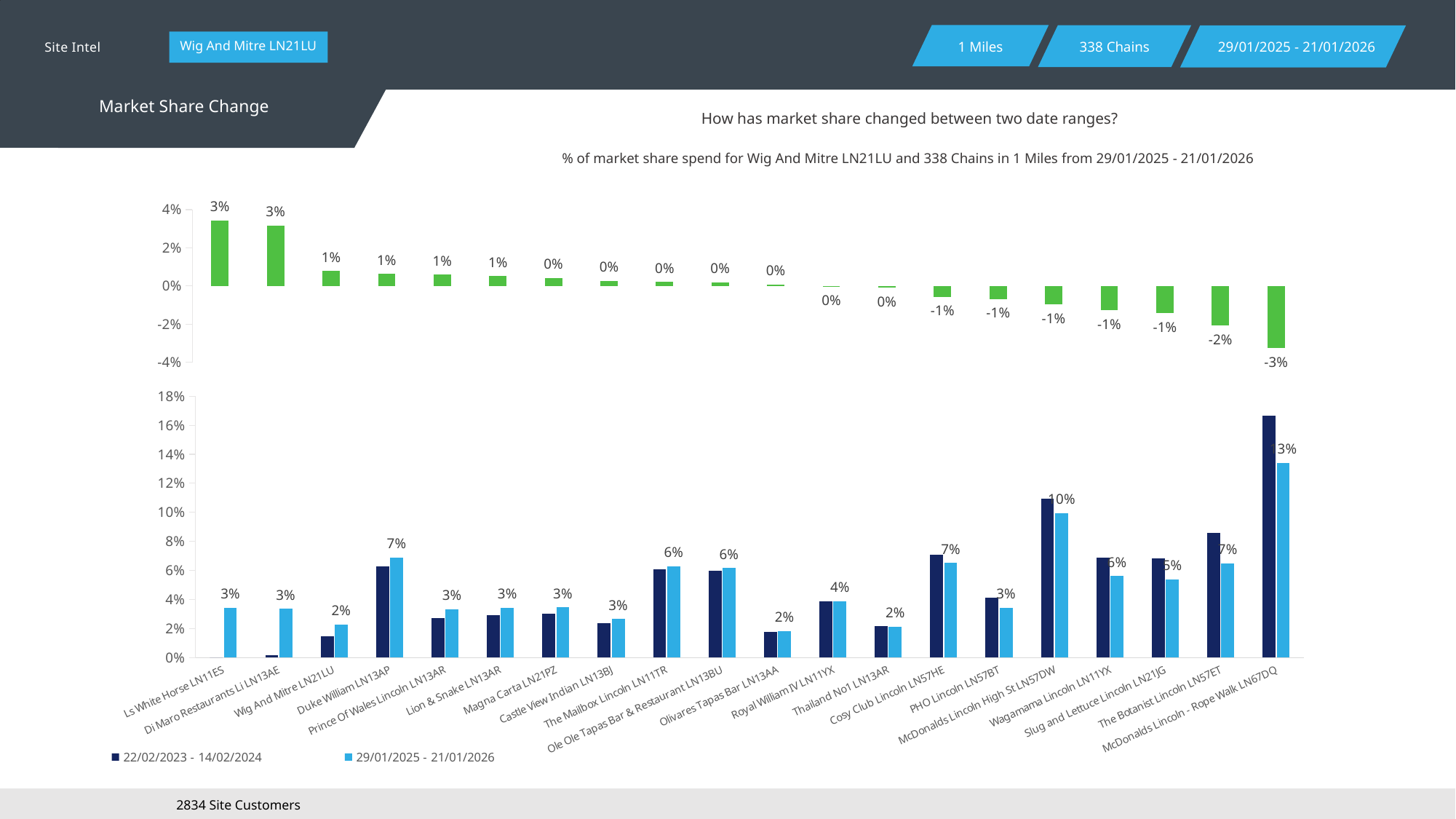
On the top chart (market share change), what is the value for Ls White Horse LN11ES? 3% On the top chart (market share change), which category has the lowest value? McDonalds Lincoln - Rope Walk LN67DQ On the bottom chart, is the 22/02/2023 - 14/02/2024 value for McDonalds Lincoln - Rope Walk LN67DQ greater or less than 14%? greater On the bottom chart, what is the value for McDonalds Lincoln High St LN57DW in the 29/01/2025 - 21/01/2026 series? 10% On the top chart (market share change), what is the value for McDonalds Lincoln - Rope Walk LN67DQ? -3% On the bottom chart, how many series does the legend list? 2 On the top chart (market share change), how many categories are plotted? 20 What kind of chart is the bottom chart? bar chart On the bottom chart, which category has the highest value in the 29/01/2025 - 21/01/2026 series? McDonalds Lincoln - Rope Walk LN67DQ On the bottom chart, in the 29/01/2025 - 21/01/2026 series, which is larger: Duke William LN13AP or Wig And Mitre LN21LU? Duke William LN13AP On the top chart (market share change), what is the value for The Botanist Lincoln LN57ET? -2% On the bottom chart, what is the first series listed in the legend? 22/02/2023 - 14/02/2024